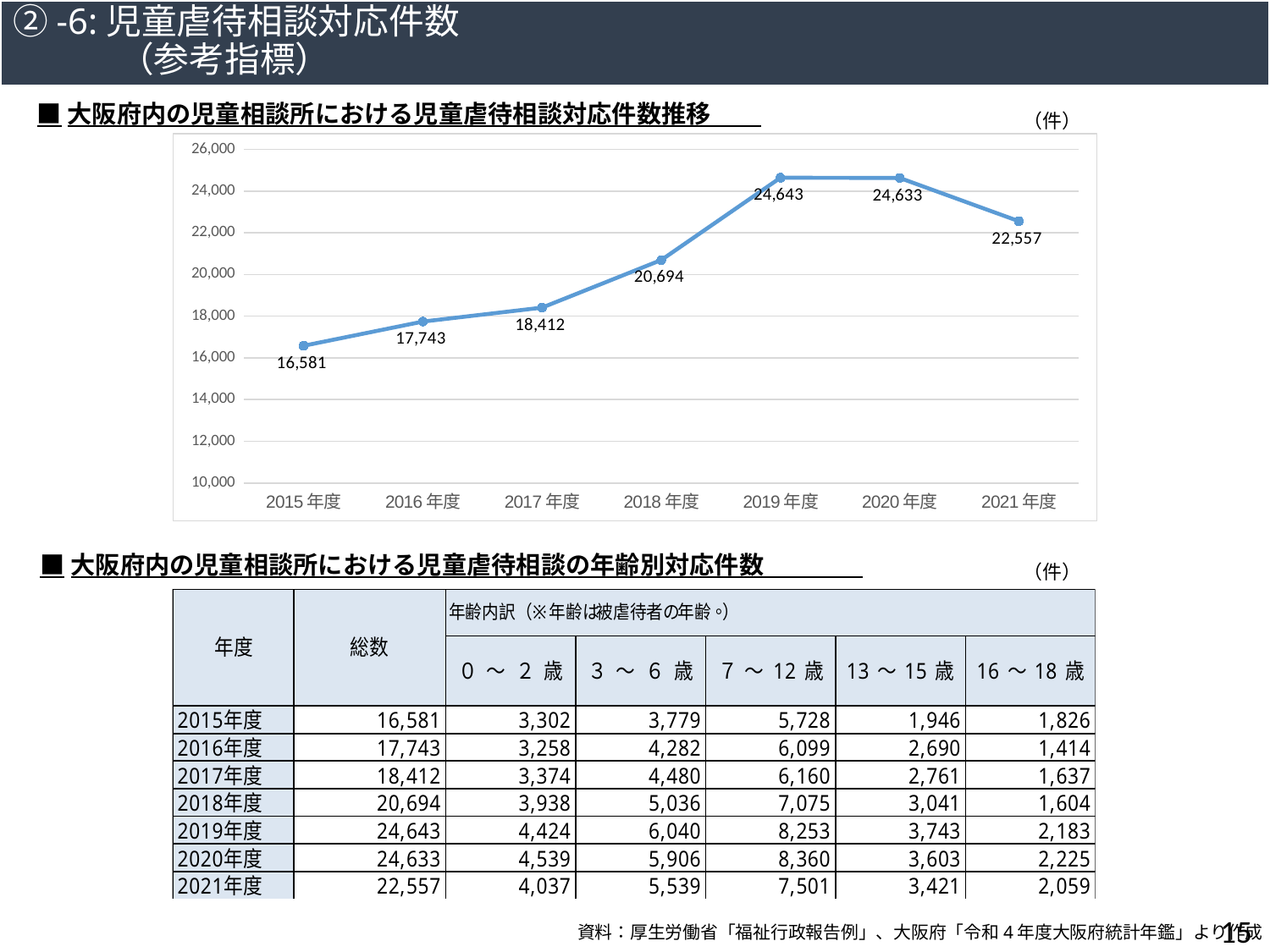
Do the values in the line chart rise or fall from 2015年度 to 2019年度? rise What kind of chart is shown on the slide? line chart What is the value for 2018年度 in the line chart? 20,694 Which is larger in the line chart, the value for 2017年度 or the value for 2016年度? 2017年度 What is the difference between the values for 2019年度 and 2018年度 in the line chart? 3,949 By how much did the value fall from 2020年度 to 2021年度 in the line chart? 2,076 How many data points are plotted in the line chart? 7 What is the value for 2021年度 in the line chart? 22,557 Which year has the highest value in the line chart? 2019年度 Which year has the lowest value in the line chart? 2015年度 Is the value for 2018年度 in the line chart greater or less than 20,000? greater What is the value for 2015年度 in the line chart? 16,581